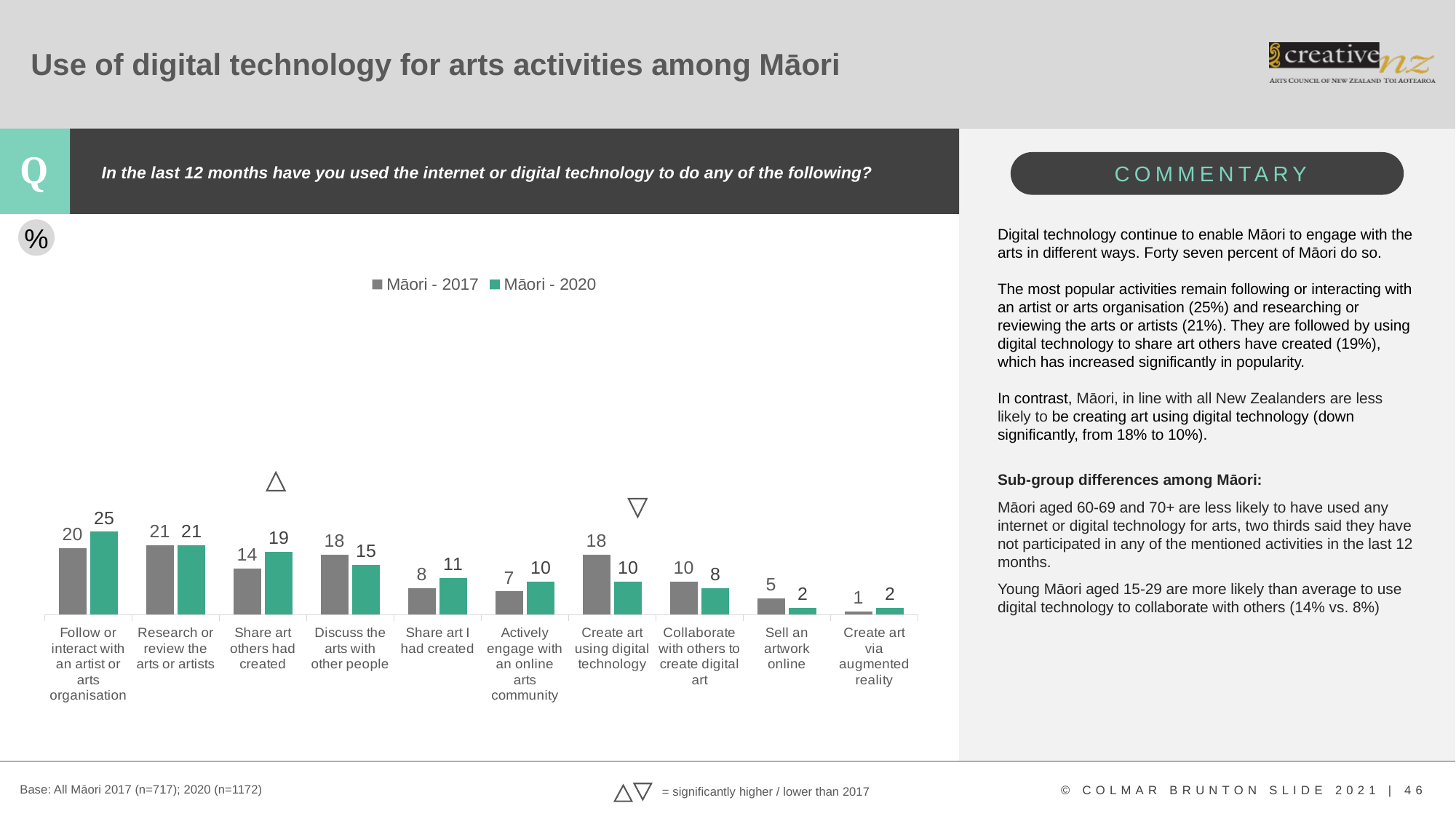
How many series does the legend list? 2 Which category has the lowest value for Māori - 2017? Create art via augmented reality How many categories are shown on the x axis of the chart? 10 Which is larger for 'Discuss the arts with other people': the Māori - 2017 value or the Māori - 2020 value? Māori - 2017 What kind of chart is shown on the slide? Bar chart Which series is shown in green in the chart? Māori - 2020 Which category has the highest value for Māori - 2020? Follow or interact with an artist or arts organisation What is the difference between the Māori - 2017 and Māori - 2020 values for 'Create art using digital technology'? 8 What is the value for Māori - 2020 for 'Sell an artwork online'? 2 What is the value for Māori - 2017 for 'Create art using digital technology'? 18 What is the value for Māori - 2020 for 'Follow or interact with an artist or arts organisation'? 25 What is the difference between the Māori - 2020 and Māori - 2017 values for 'Share art others had created'? 5